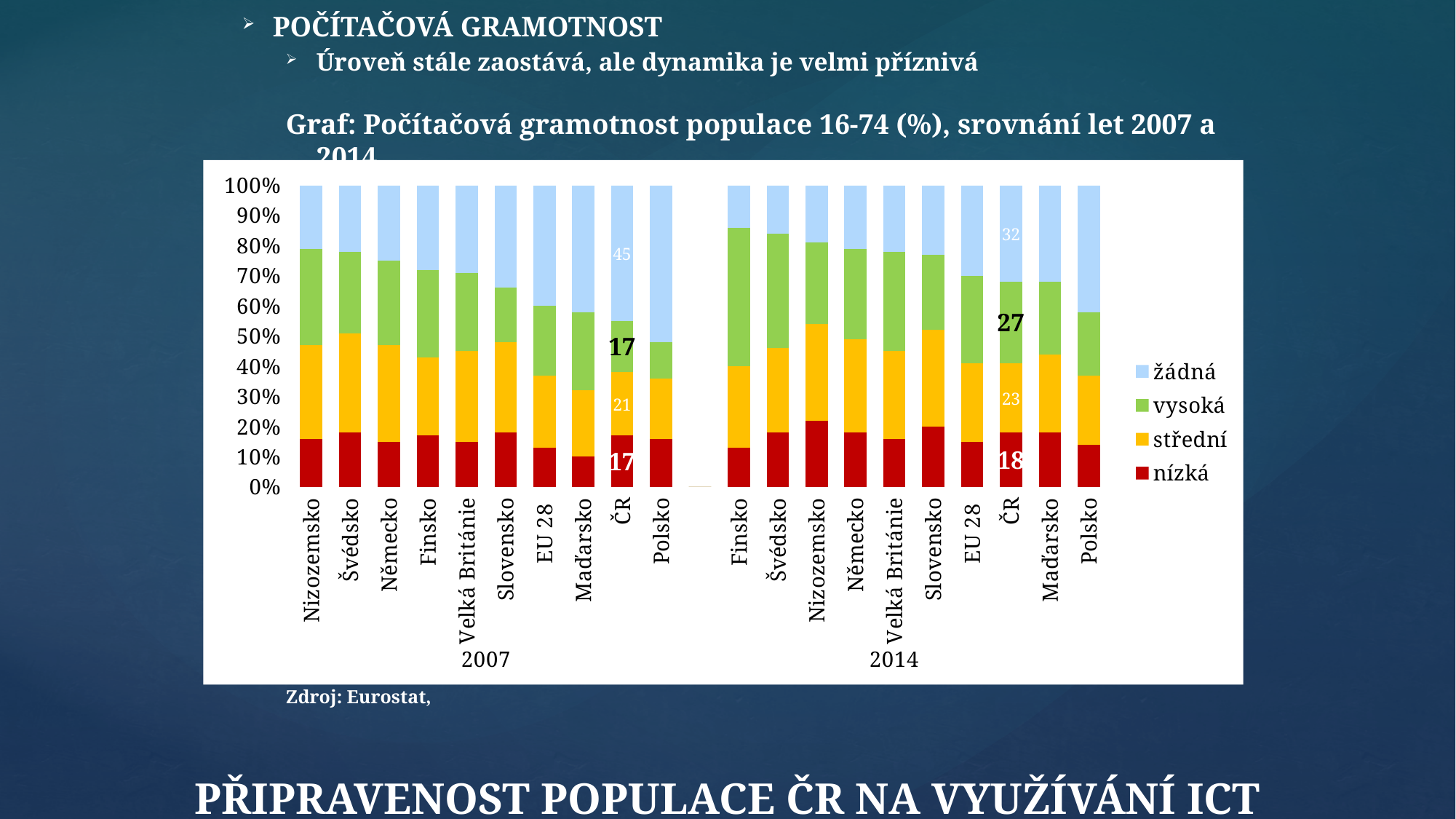
For ČR, is the vysoká value larger in 2007 or in 2014? 2014 How many countries/categories are shown in the 2007 group? 10 How many series does the legend list? 4 Which series is shown in light blue at the top of each bar? žádná In the 2014 group, what is the difference between the vysoká (27) and nízká (18) labels for ČR? 9 In the 2014 group, what is the data label for the vysoká segment of the ČR bar? 27 In the 2007 group, does the top of the vysoká segment for Nizozemsko reach greater or less than 70%? greater What kind of chart is shown on the slide? Stacked bar chart In the 2014 group, what is the data label for the nízká segment of the ČR bar? 18 In the 2007 group, what is the data label for the střední segment of the ČR bar? 21 By how much did the žádná value for ČR fall from 2007 (45) to 2014 (32)? 13 In the 2007 group, what is the data label for the žádná segment of the ČR bar? 45